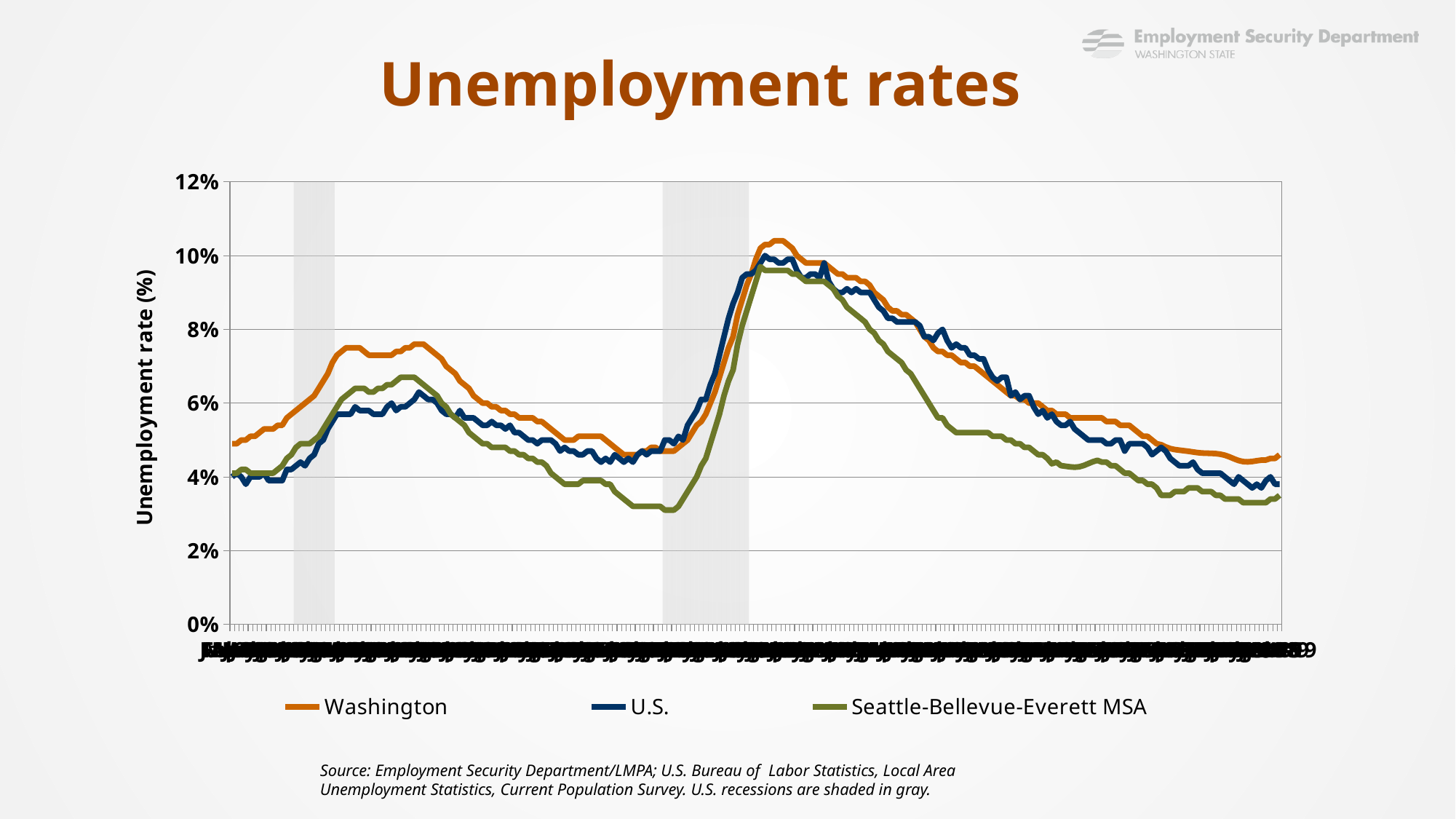
Is the value of the Washington series at the right end of the chart greater or less than 4%? greater What are the three series named in the legend? Washington, U.S., Seattle-Bellevue-Everett MSA Which series reaches the highest peak on the chart? Washington Do the unemployment rates rise or fall across the right-hand third of the chart, after the second shaded recession? fall What is the label of the vertical axis? Unemployment rate (%) How many series does the legend list? 3 Which series is lowest at the right end of the chart? Seattle-Bellevue-Everett MSA At the highest peak of the chart, which series is larger, Washington or Seattle-Bellevue-Everett MSA? Washington Is the lowest value of the Seattle-Bellevue-Everett MSA series greater or less than 4%? less What kind of chart is shown on the slide? line chart Is the highest value of the Washington series greater or less than 10%? greater